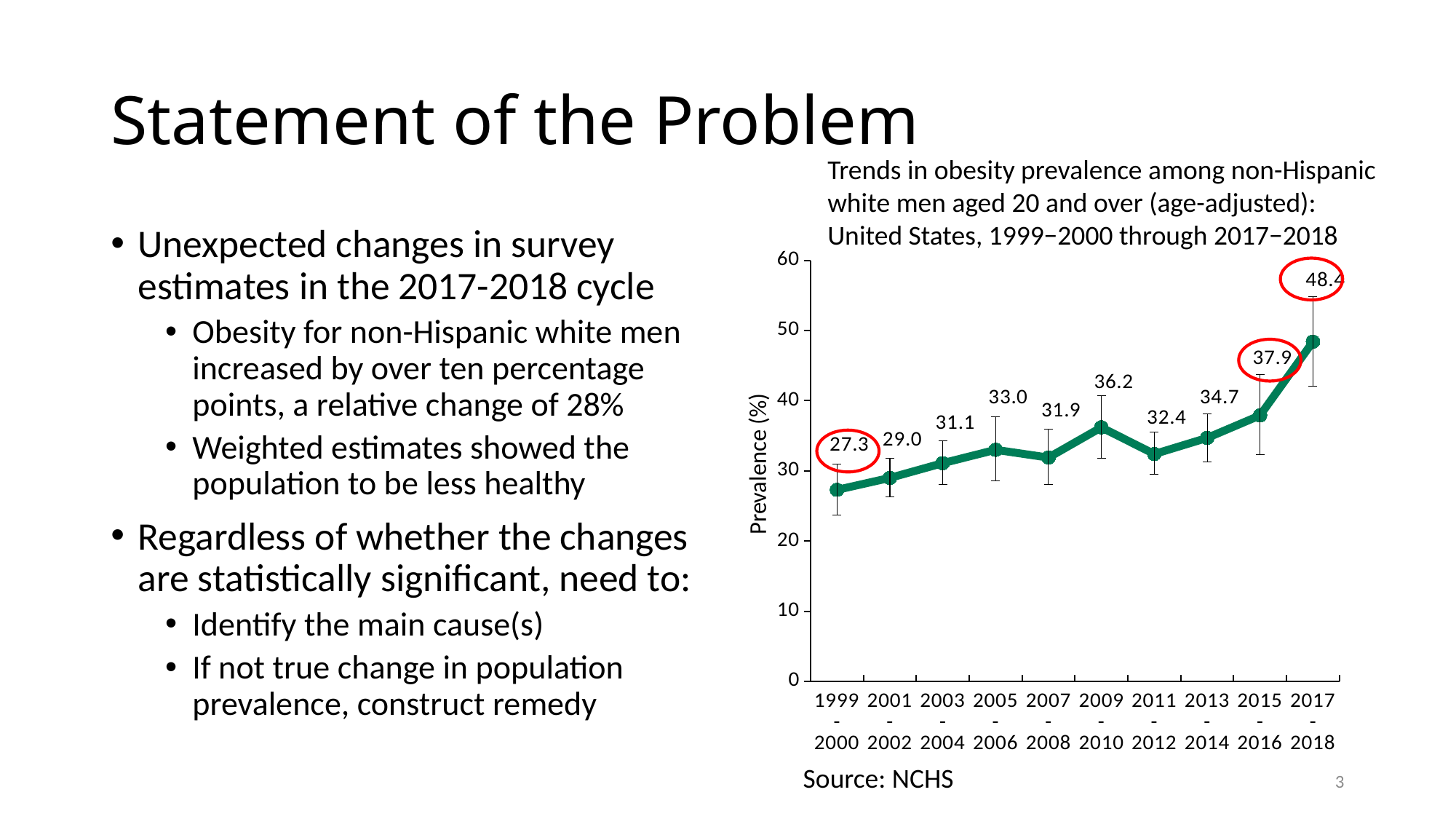
Is the value for 2015-2016 greater or less than 40? less What is the obesity prevalence for 1999-2000? 27.3 Which survey cycle has the lowest obesity prevalence? 1999-2000 Which is larger, the prevalence for 2009-2010 or for 2011-2012? 2009-2010 What is the label of the y axis? Prevalence (%) Which survey cycle has the highest obesity prevalence? 2017-2018 What is the obesity prevalence for 2017-2018? 48.4 What kind of chart is shown on the slide? line chart How many survey cycles are plotted on the chart? 10 What is the obesity prevalence for 2009-2010? 36.2 Does obesity prevalence generally rise or fall from 1999-2000 to 2017-2018? rise What is the difference in prevalence between 2017-2018 and 2015-2016? 10.5